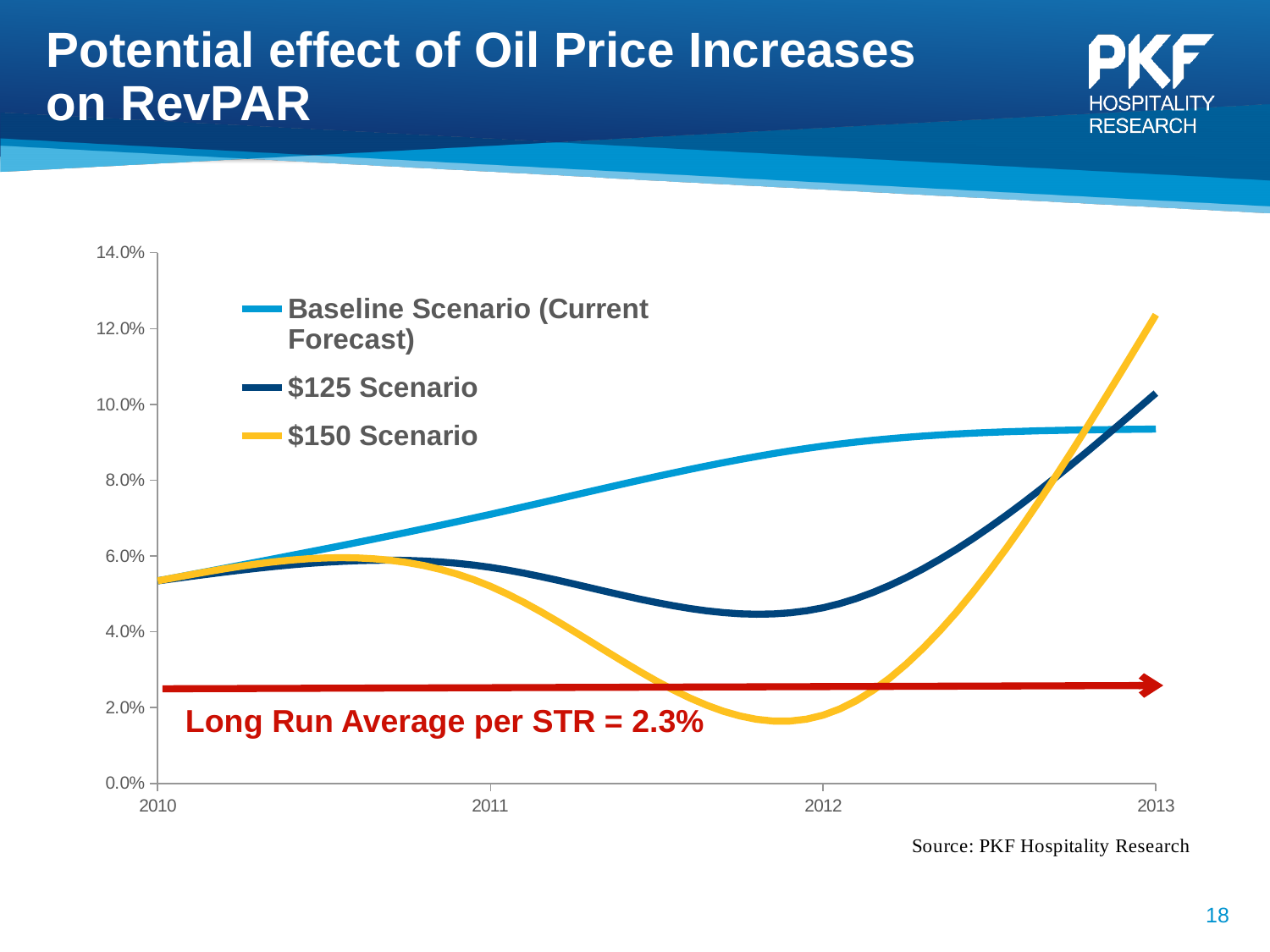
How many years are labelled on the x axis? 4 What kind of chart is shown on the slide? Line chart How many series does the legend list? 3 Is the value for the $150 Scenario in 2013 greater or less than 10.0%? greater Is the value for the $125 Scenario in 2012 greater or less than 6.0%? less Does the Baseline Scenario (Current Forecast) line rise or fall from 2010 to 2013? Rise Is the value for the Baseline Scenario (Current Forecast) in 2013 greater or less than 8.0%? greater Which series has the highest value in 2013? $150 Scenario Which series has the lowest value in 2012? $150 Scenario In 2012, which is higher: the Baseline Scenario (Current Forecast) or the $150 Scenario? Baseline Scenario (Current Forecast) What value is given for the Long Run Average per STR on the chart? 2.3%